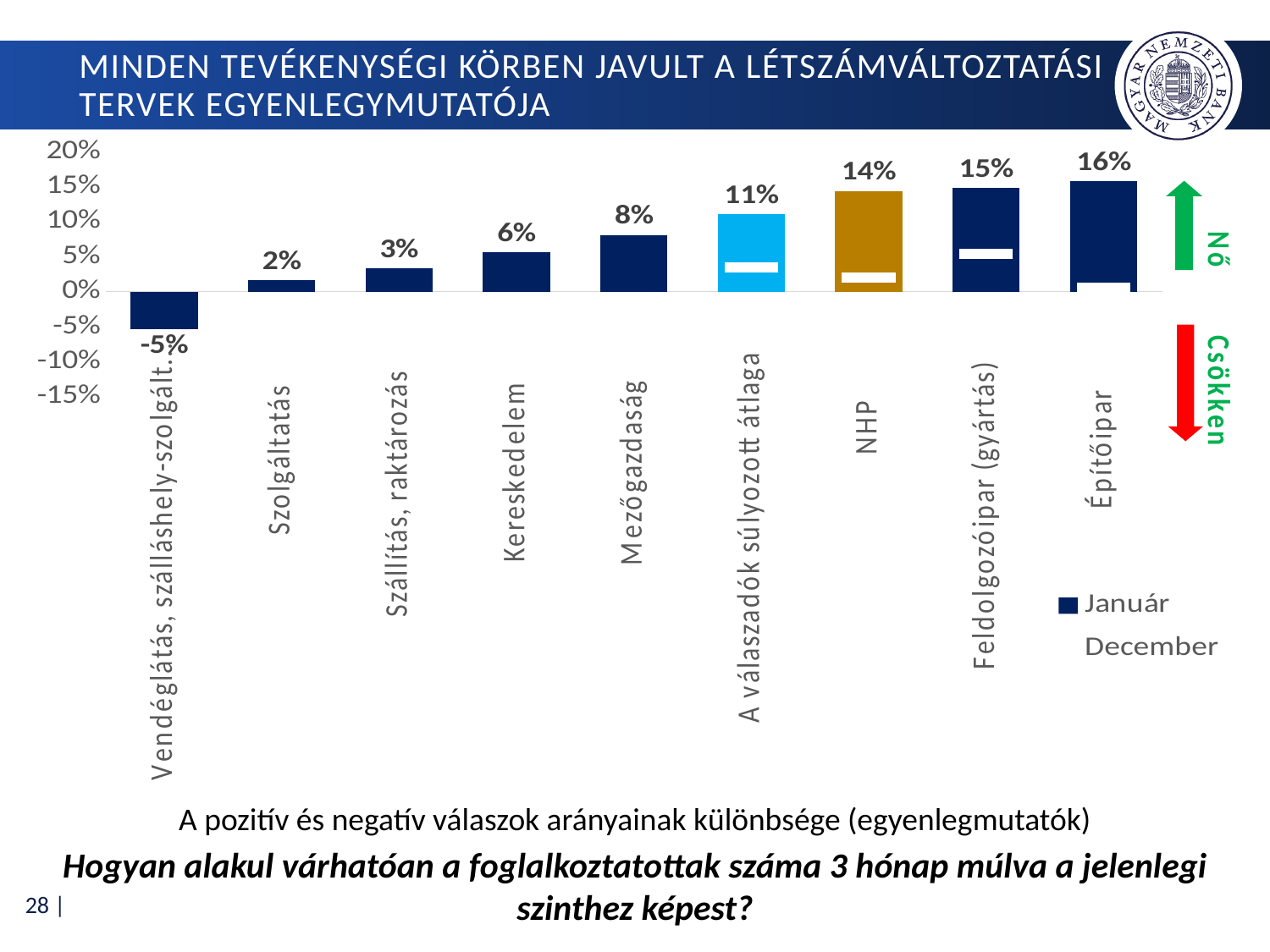
Which category has the highest labelled value? Építőipar What is the value shown for Vendéglátás, szálláshely-szolgált.? -5% What is the difference between the labelled values for NHP and Mezőgazdaság? 6% What is the value shown for Kereskedelem? 6% What is the value shown for Építőipar? 16% Which has a larger labelled value, Szállítás, raktározás or Kereskedelem? Kereskedelem What kind of chart is shown on the slide? bar chart Which category has the lowest labelled value? Vendéglátás, szálláshely-szolgált. How many series does the legend list? 2 Do the labelled values rise or fall from left to right along the x axis? rise How many categories are shown on the x axis? 9 What is the value shown for A válaszadók súlyozott átlaga? 11%